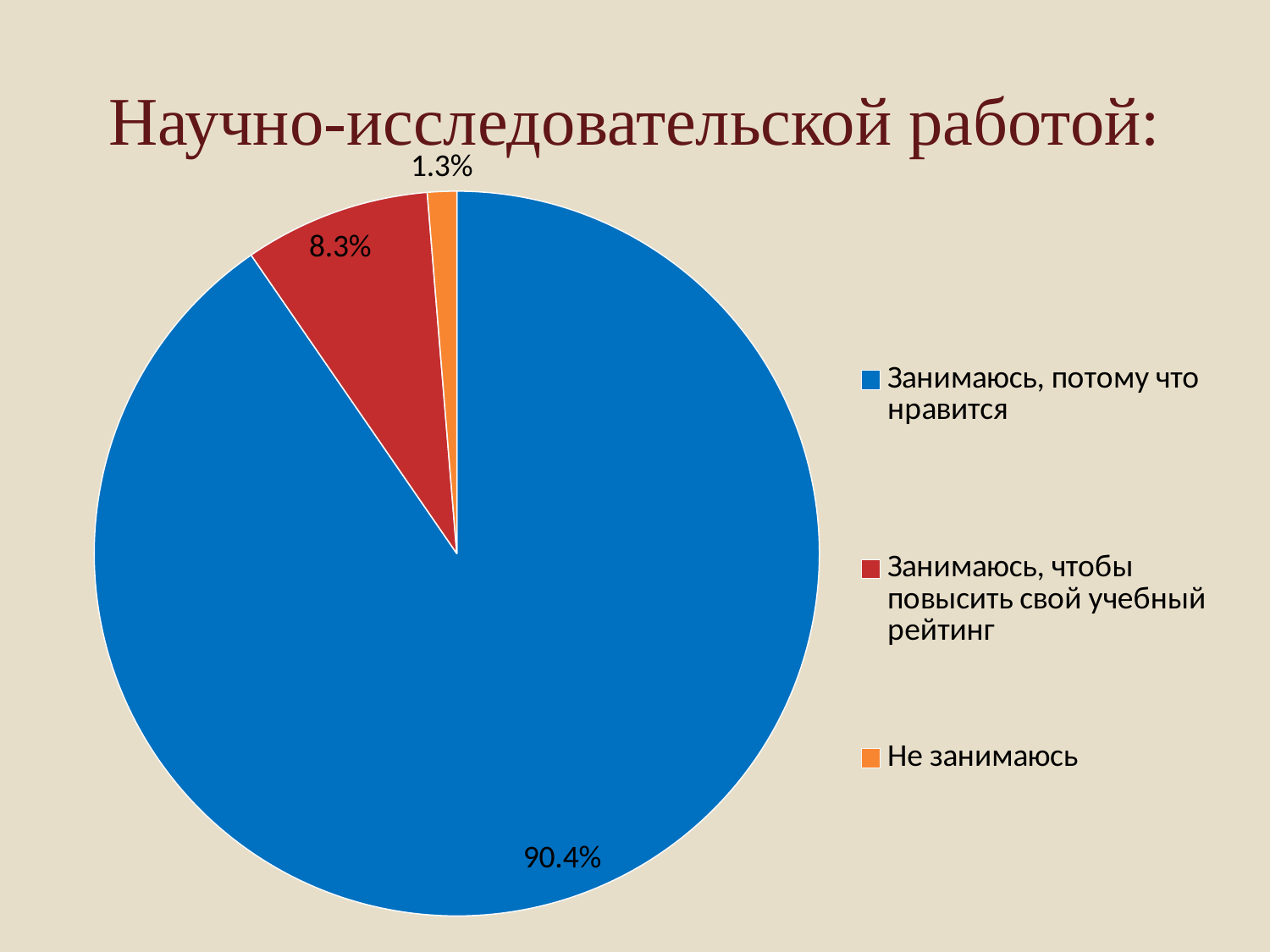
What is the title of the slide? Научно-исследовательской работой: What share of the pie is labelled "Занимаюсь, потому что нравится"? 90.4% Which is larger: the "Занимаюсь, чтобы повысить свой учебный рейтинг" slice or the "Не занимаюсь" slice? Занимаюсь, чтобы повысить свой учебный рейтинг Which category has the smallest slice of the pie? Не занимаюсь Which category has the largest slice of the pie? Занимаюсь, потому что нравится What type of chart is shown on the slide? Pie chart What share of the pie is labelled "Не занимаюсь"? 1.3% What is the combined share of the two "Занимаюсь" slices? 98.7% What is the difference in percentage points between the "Занимаюсь, потому что нравится" slice and the "Занимаюсь, чтобы повысить свой учебный рейтинг" slice? 82.1 What share of the pie is labelled "Занимаюсь, чтобы повысить свой учебный рейтинг"? 8.3% What colour is the slice for "Не занимаюсь"? Orange How many slices does the pie chart have? 3